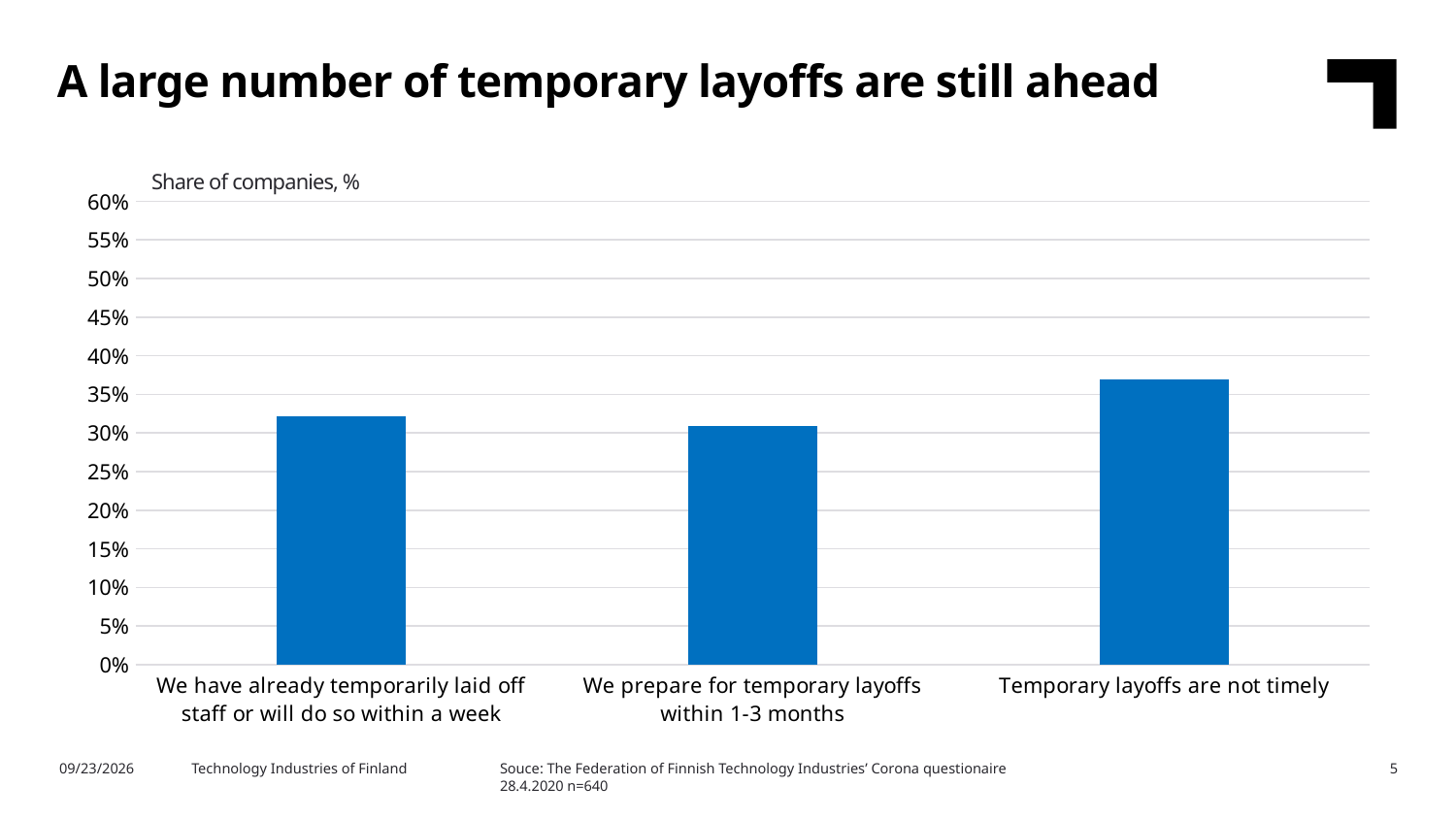
How many categories are shown in the chart? 3 Is the value for "We prepare for temporary layoffs within 1-3 months" greater or less than 35%? less Is the value for "We prepare for temporary layoffs within 1-3 months" greater or less than 25%? greater Is the value for "We have already temporarily laid off staff or will do so within a week" greater or less than 30%? greater What is the title of the slide? A large number of temporary layoffs are still ahead Which category has the highest share of companies? Temporary layoffs are not timely Which is larger: the value for "Temporary layoffs are not timely" or the value for "We prepare for temporary layoffs within 1-3 months"? Temporary layoffs are not timely What is the label shown above the vertical axis of the chart? Share of companies, % What kind of chart is shown on the slide? bar chart